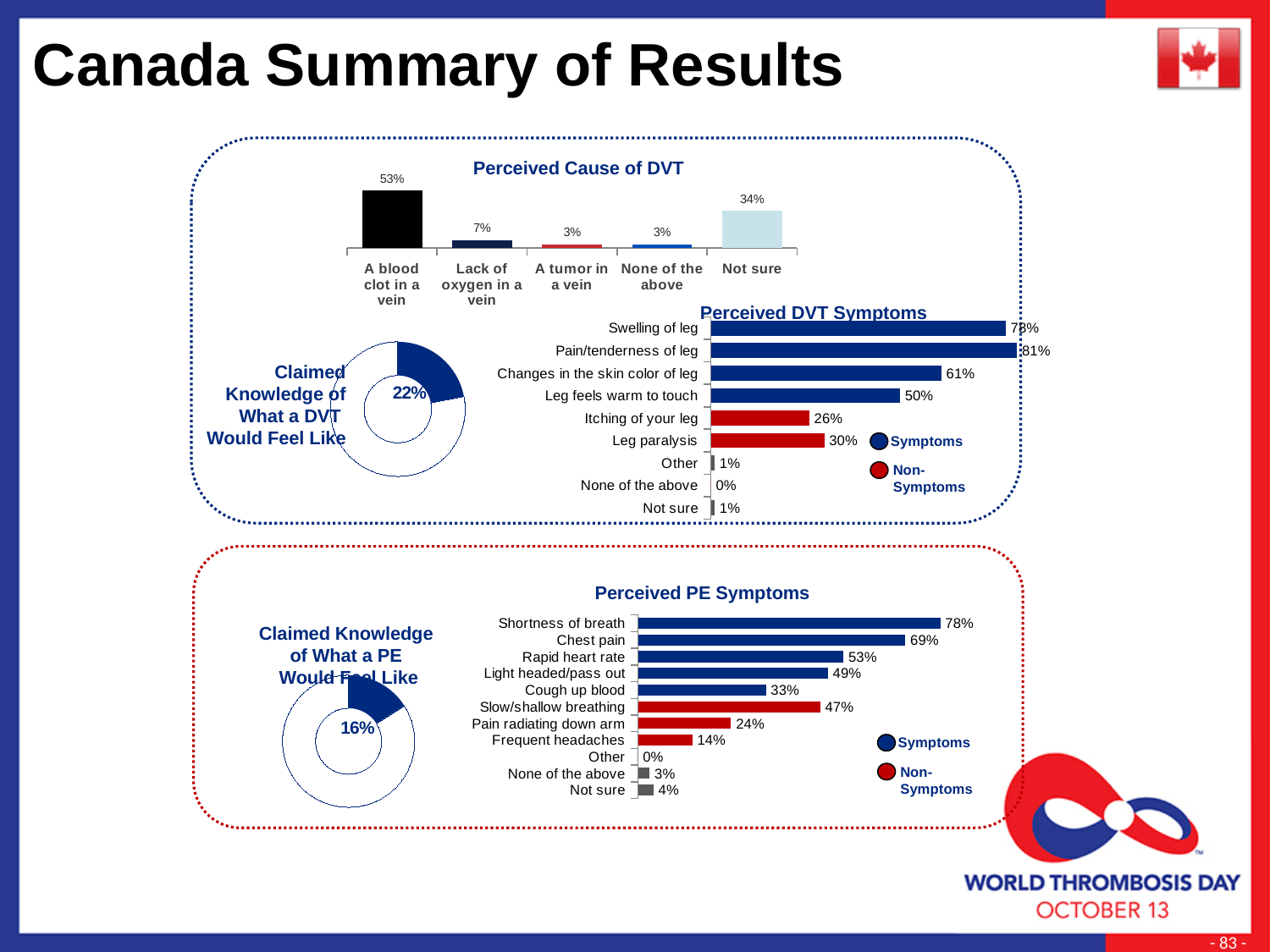
In the Perceived PE Symptoms chart, what is the value for "Chest pain"? 69% In the Perceived DVT Symptoms chart, what is the difference between "Changes in the skin color of leg" and "Leg feels warm to touch"? 11% In the Perceived DVT Symptoms chart, which is larger: "Itching of your leg" or "Leg paralysis"? Leg paralysis What percentage is shown in the "Claimed Knowledge of What a PE Would Feel Like" donut chart? 16% In the Perceived DVT Symptoms chart, what is the value for "Pain/tenderness of leg"? 81% In the Perceived DVT Symptoms chart, which symptom has the highest value? Pain/tenderness of leg What percentage is shown in the "Claimed Knowledge of What a DVT Would Feel Like" donut chart? 22% What type of chart is the Perceived PE Symptoms chart? Bar chart In the Perceived PE Symptoms chart, what is the difference between "Shortness of breath" and "Frequent headaches"? 64% In the Perceived Cause of DVT chart, how many categories are shown? 5 In the Perceived Cause of DVT chart, what is the value for "A blood clot in a vein"? 53% In the Perceived Cause of DVT chart, which category has the lowest value? A tumor in a vein and None of the above (both 3%)